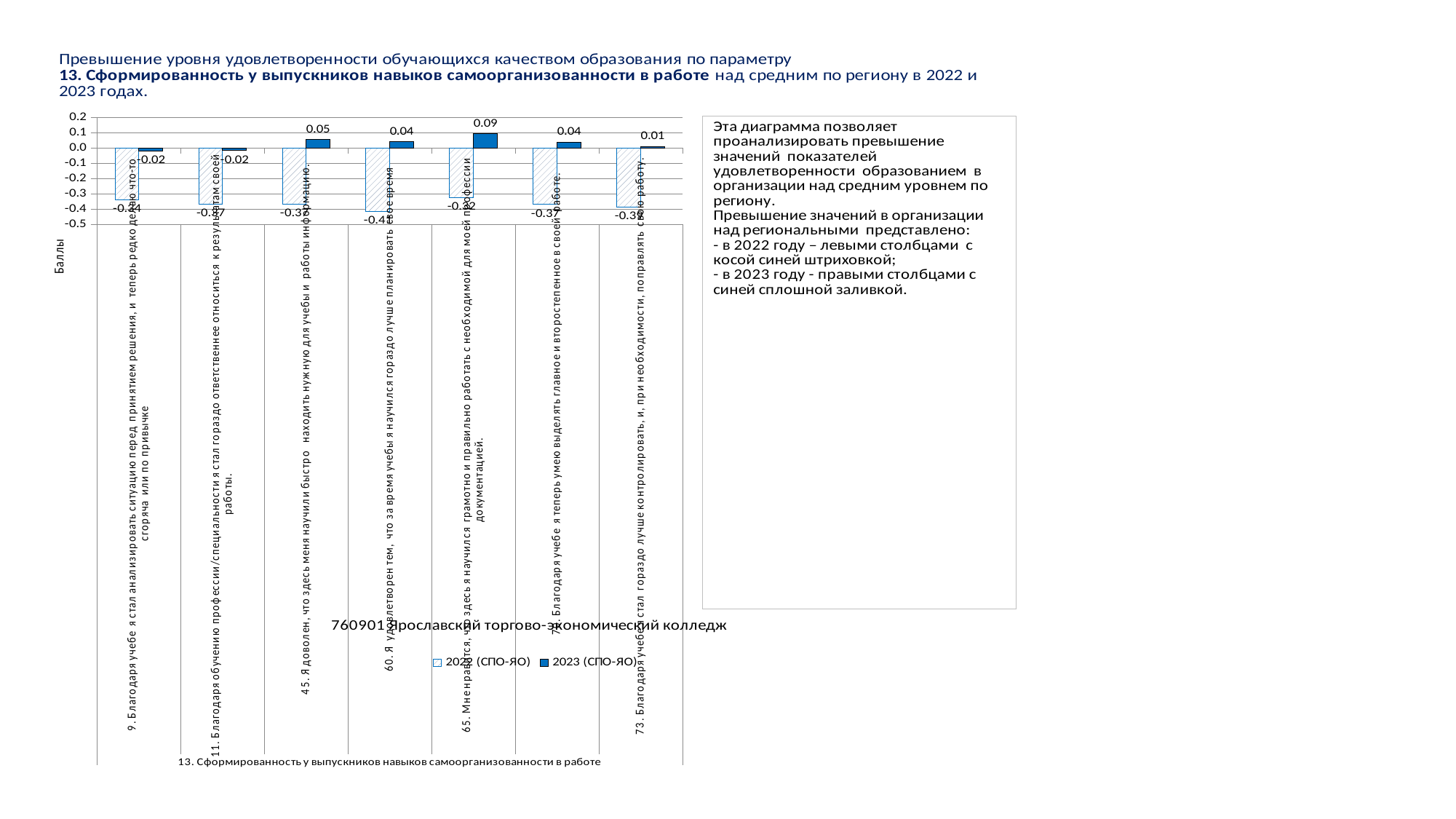
How many categories (statements) are plotted on the x axis? 7 What kind of chart is shown on the slide? bar chart Is the 2022 value for statement 60 greater or less than -0.4? less Which statement has the lowest 2022 (СПО-ЯО) value? 60 Which is larger: the 2023 value for statement 45 or the 2023 value for statement 60? statement 45 What is the 2023 (СПО-ЯО) value for statement 65 ("Мне нравится, что здесь я научился грамотно и правильно работать...")? 0.09 What are the two legend entries of the chart? 2022 (СПО-ЯО) and 2023 (СПО-ЯО) What is the 2022 (СПО-ЯО) value for statement 9 ("Благодаря учебе я стал анализировать ситуацию...")? -0.34 Which statement has the highest 2023 (СПО-ЯО) value? 65 How many series does the legend list? 2 For statement 65, what is the difference between the 2023 value and the 2022 value? 0.41 What is the 2023 (СПО-ЯО) value for statement 73 ("Благодаря учебе я стал гораздо лучше контролировать...")? 0.01